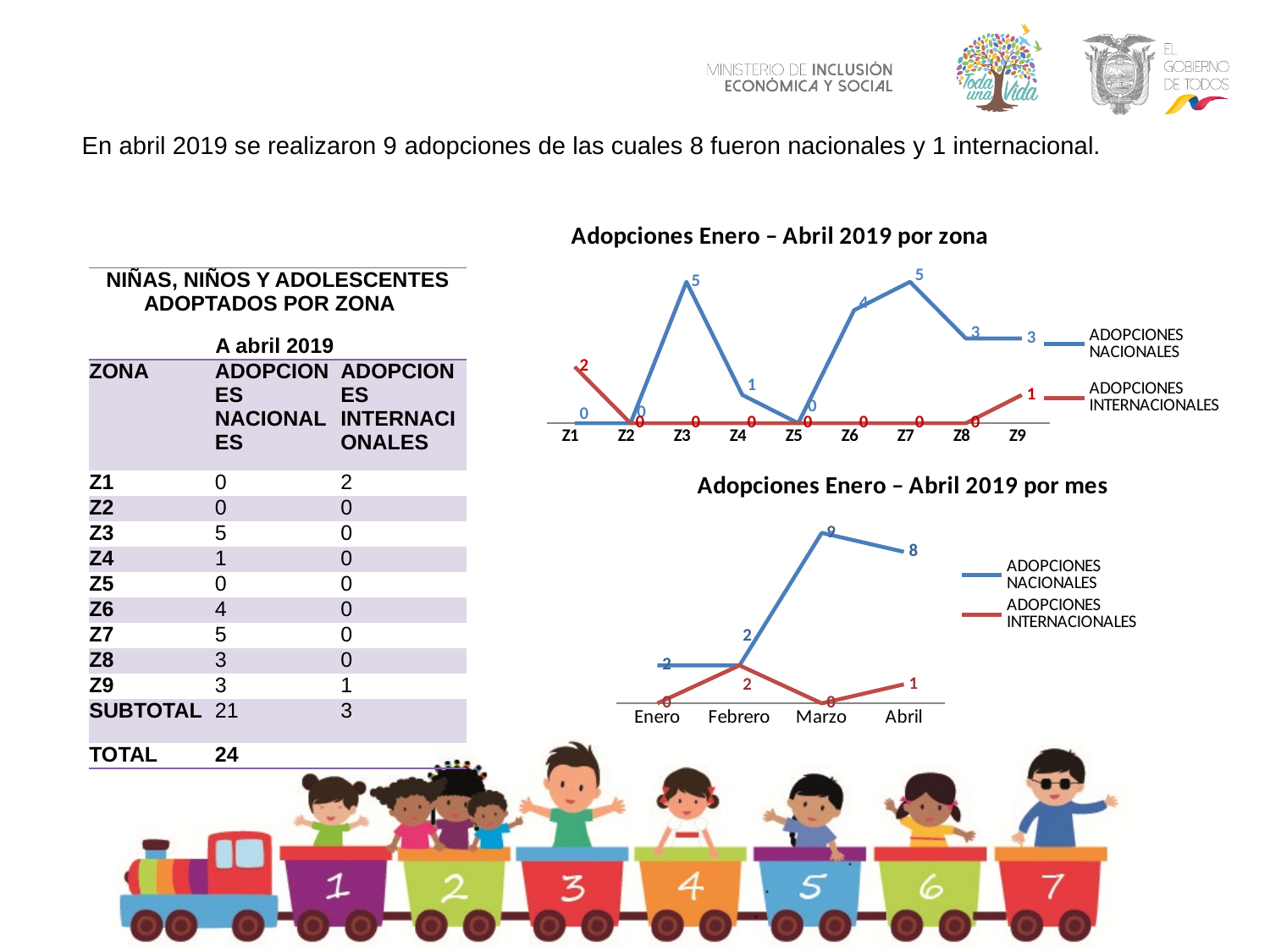
In the chart 'Adopciones Enero – Abril 2019 por mes', which month has the highest value for ADOPCIONES NACIONALES? Marzo In the chart 'Adopciones Enero – Abril 2019 por mes', which month has the highest value for ADOPCIONES INTERNACIONALES? Febrero What type of chart is 'Adopciones Enero – Abril 2019 por zona'? Line chart In the chart 'Adopciones Enero – Abril 2019 por mes', how many series does the legend list? 2 In the chart 'Adopciones Enero – Abril 2019 por mes', what colour is the ADOPCIONES INTERNACIONALES line? Red In the chart 'Adopciones Enero – Abril 2019 por zona', what is the difference between ADOPCIONES NACIONALES for Z3 and for Z4? 4 In the chart 'Adopciones Enero – Abril 2019 por zona', how many zones are shown on the x axis? 9 In the chart 'Adopciones Enero – Abril 2019 por zona', what is the value of ADOPCIONES NACIONALES for Z6? 4 In the chart 'Adopciones Enero – Abril 2019 por mes', what is the value of ADOPCIONES NACIONALES for Abril? 8 In the chart 'Adopciones Enero – Abril 2019 por zona', which is larger for Z9: ADOPCIONES NACIONALES or ADOPCIONES INTERNACIONALES? ADOPCIONES NACIONALES In the chart 'Adopciones Enero – Abril 2019 por mes', what is the difference between ADOPCIONES NACIONALES for Marzo and for Febrero? 7 In the chart 'Adopciones Enero – Abril 2019 por zona', what is the value of ADOPCIONES INTERNACIONALES for Z1? 2